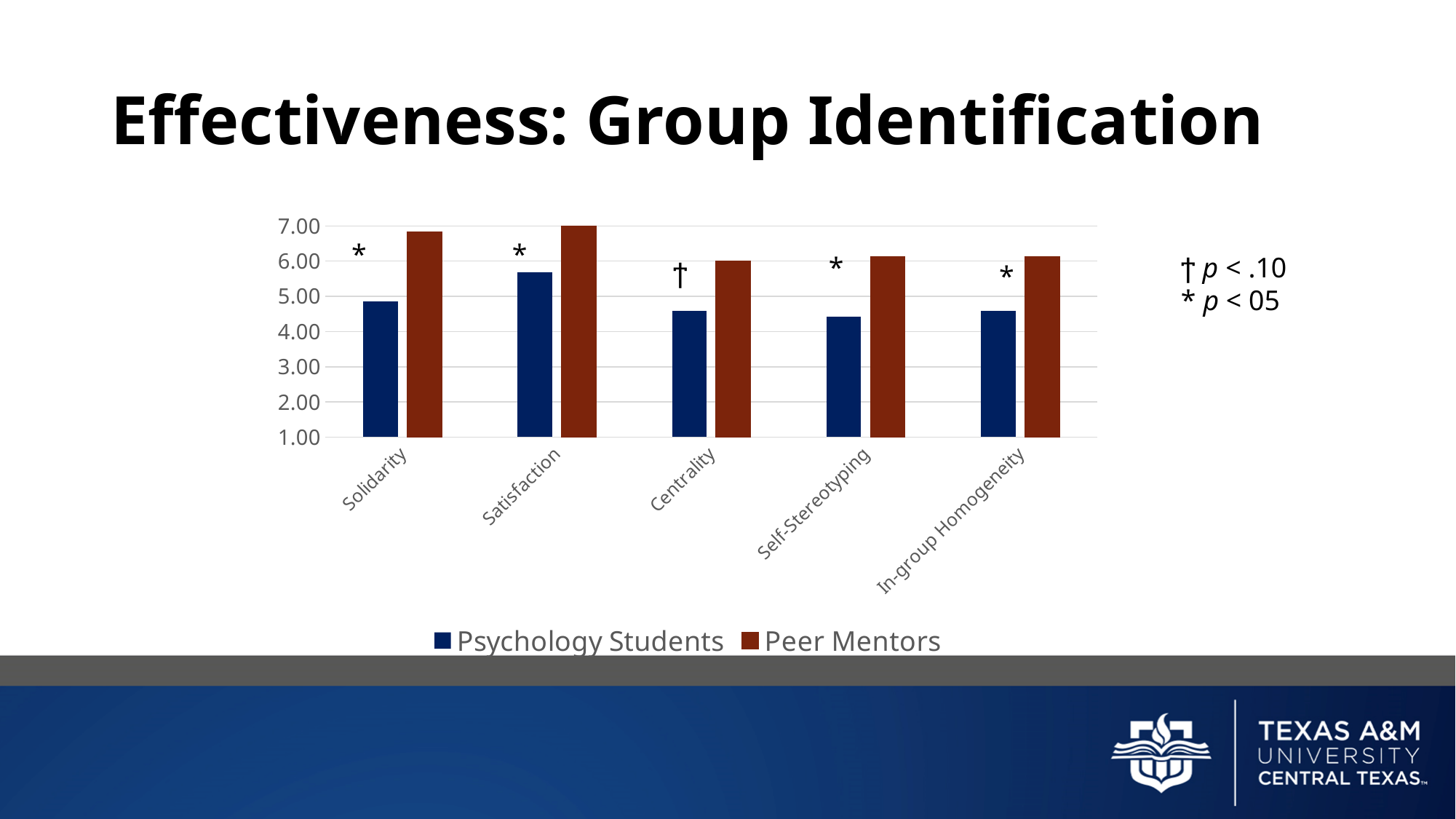
How many categories are shown on the x axis? 5 Which series is shown in dark blue? Psychology Students What kind of chart is shown on the slide? Bar chart Is the value for Peer Mentors in Solidarity greater or less than 6.00? greater For Psychology Students, which is larger: Satisfaction or Centrality? Satisfaction What are the two series listed in the legend? Psychology Students and Peer Mentors For Solidarity, which is larger: Psychology Students or Peer Mentors? Peer Mentors Which category has the highest value for Peer Mentors? Satisfaction Which category has the highest value for Psychology Students? Satisfaction Is the value for Psychology Students in Satisfaction greater or less than 5.00? greater How many series does the legend list? 2